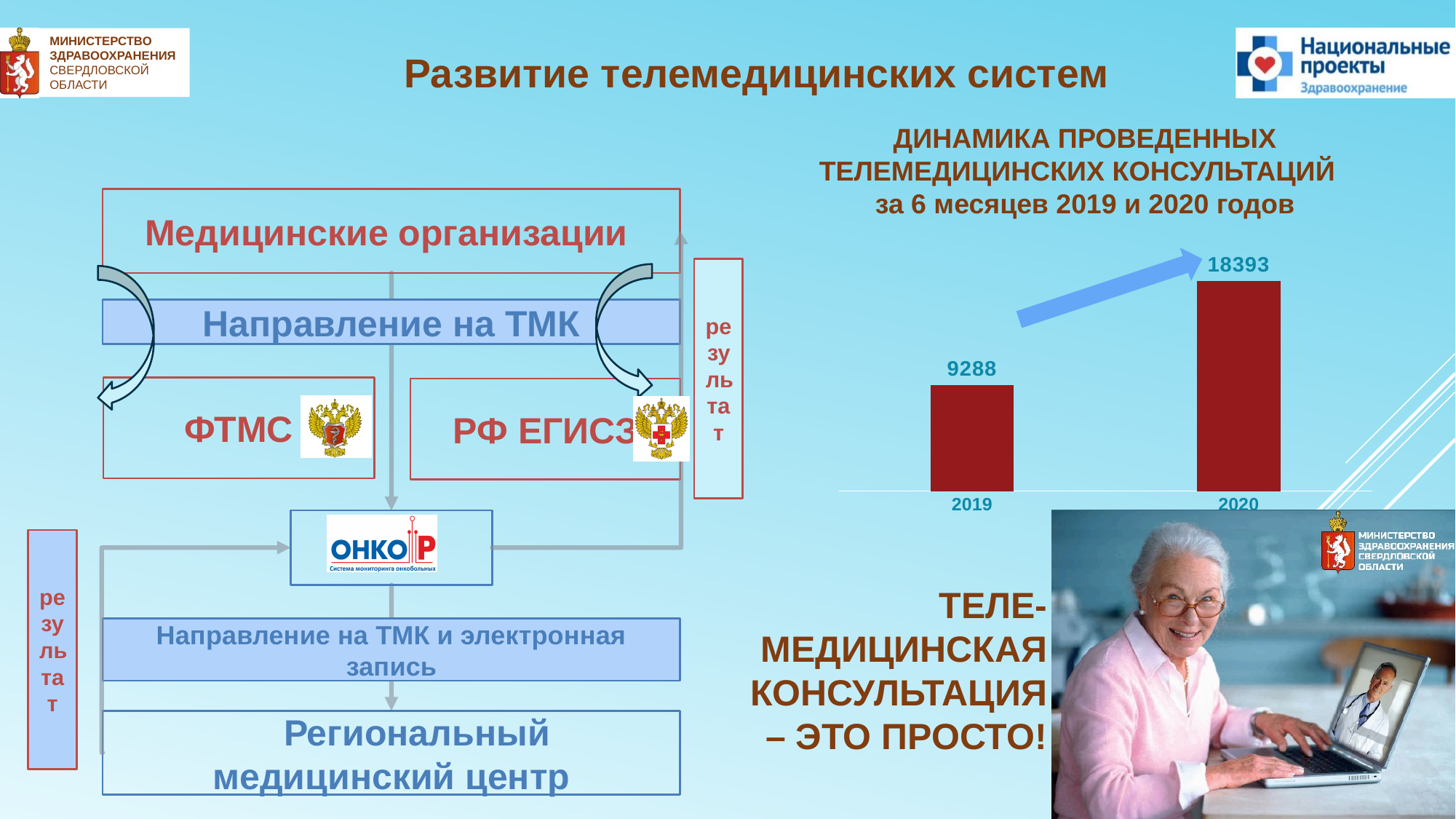
What is the value for 2019 in the chart? 9288 Which year has the highest value in the chart? 2020 What colour are the bars in the chart? dark red What is the value for 2020 in the chart? 18393 How many bars are shown in the chart? 2 Which year has the lowest value in the chart? 2019 What is the title of the chart? ДИНАМИКА ПРОВЕДЕННЫХ ТЕЛЕМЕДИЦИНСКИХ КОНСУЛЬТАЦИЙ за 6 месяцев 2019 и 2020 годов Which is larger, the value for 2019 or the value for 2020? 2020 What is the difference between the values for 2020 and 2019? 9105 Do the values rise or fall from 2019 to 2020? rise What kind of chart is shown on the slide? bar chart